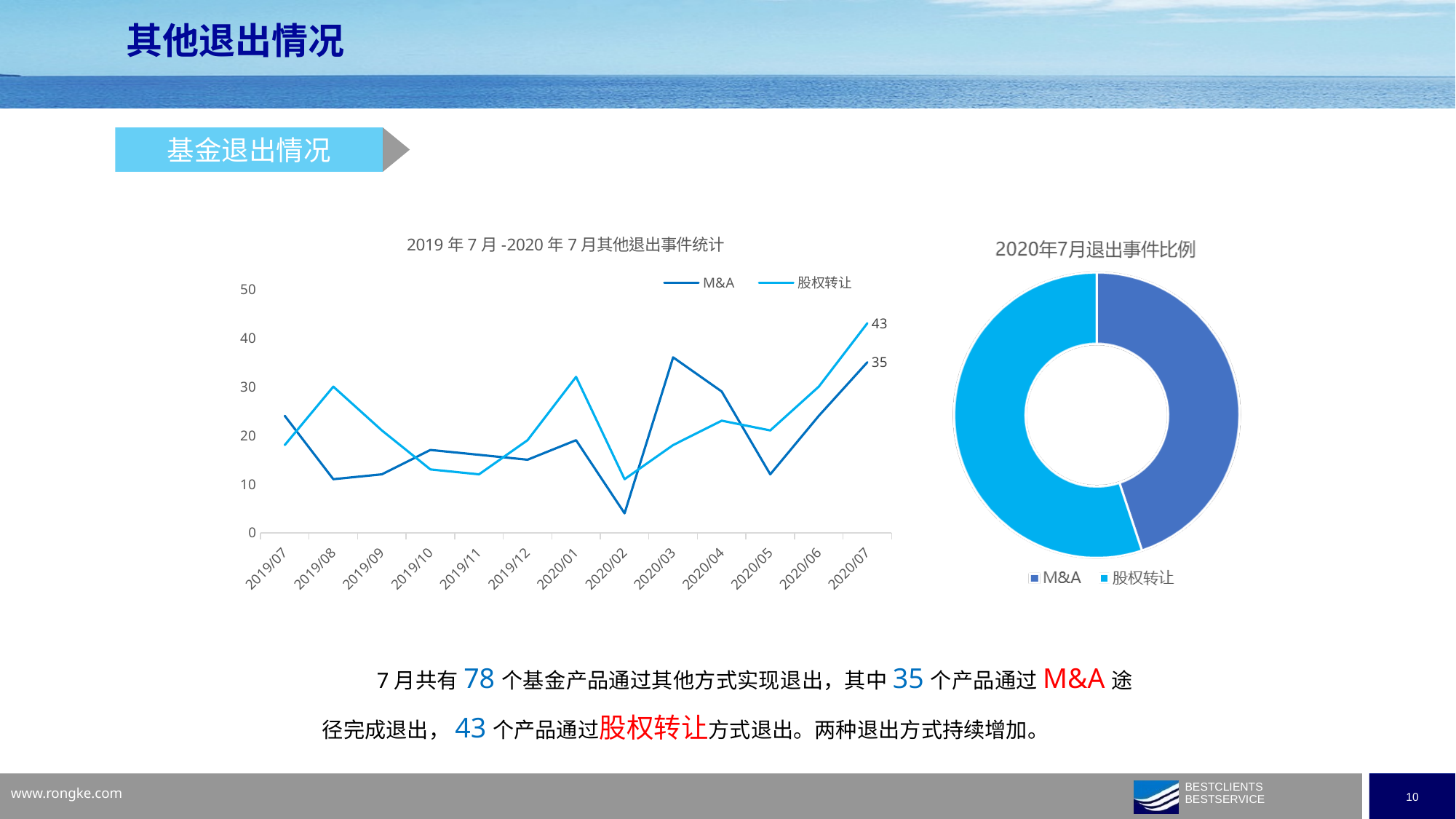
In the line chart '2019 年 7 月 -2020 年 7 月其他退出事件统计', what is the value for M&A at 2020/07? 35 In the line chart '2019 年 7 月 -2020 年 7 月其他退出事件统计', what is the difference between 股权转让 and M&A at 2020/07? 8 In the line chart '2019 年 7 月 -2020 年 7 月其他退出事件统计', in which month is the M&A series at its lowest? 2020/02 In the line chart '2019 年 7 月 -2020 年 7 月其他退出事件统计', is the value for M&A at 2020/02 greater or less than 10? less In the line chart '2019 年 7 月 -2020 年 7 月其他退出事件统计', which series has the larger value at 2020/07, M&A or 股权转让? 股权转让 In the line chart '2019 年 7 月 -2020 年 7 月其他退出事件统计', what is the value for 股权转让 at 2020/07? 43 In the line chart '2019 年 7 月 -2020 年 7 月其他退出事件统计', how many series does the legend list? 2 What kind of chart is the one titled '2019 年 7 月 -2020 年 7 月其他退出事件统计'? Line chart In the doughnut chart '2020年7月退出事件比例', which slice is larger, M&A or 股权转让? 股权转让 In the line chart '2019 年 7 月 -2020 年 7 月其他退出事件统计', in which month is the 股权转让 series at its highest? 2020/07 In the line chart '2019 年 7 月 -2020 年 7 月其他退出事件统计', is the value for M&A at 2020/03 greater or less than 30? greater In the line chart '2019 年 7 月 -2020 年 7 月其他退出事件统计', how many months are plotted on the x axis? 13